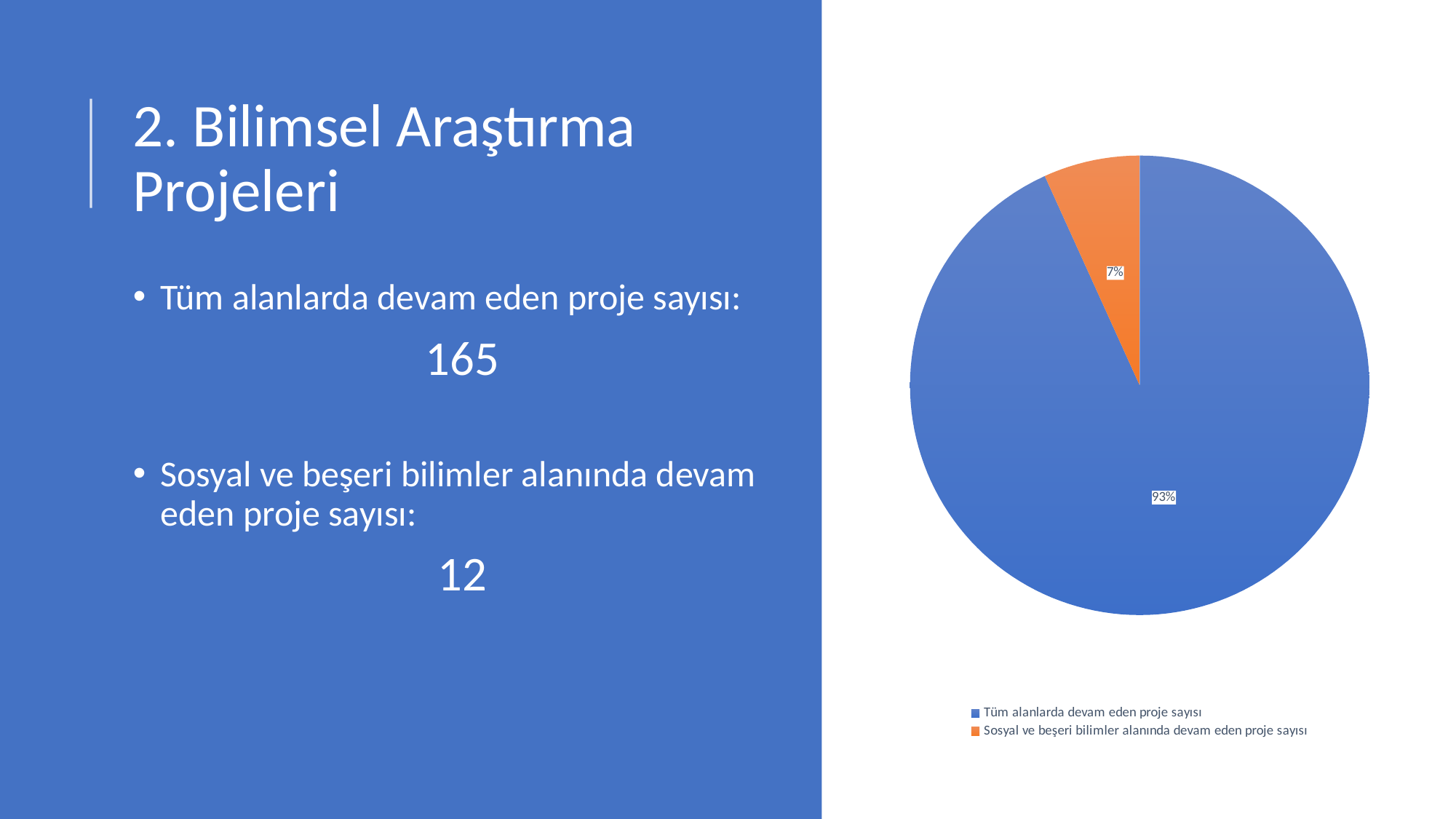
What kind of chart is shown on the slide? pie chart What share of the pie does "Sosyal ve beşeri bilimler alanında devam eden proje sayısı" take? 7% Which slice of the pie chart is the smallest? Sosyal ve beşeri bilimler alanında devam eden proje sayısı What colour is the slice for "Sosyal ve beşeri bilimler alanında devam eden proje sayısı" in the pie chart? orange What share of the pie does "Tüm alanlarda devam eden proje sayısı" take? 93% By how many percentage points does the 93% slice exceed the 7% slice? 86 Which is larger in the pie chart: the slice for "Tüm alanlarda devam eden proje sayısı" or the slice for "Sosyal ve beşeri bilimler alanında devam eden proje sayısı"? Tüm alanlarda devam eden proje sayısı What colour is the slice for "Tüm alanlarda devam eden proje sayısı" in the pie chart? blue How many slices does the pie chart have? 2 Which slice of the pie chart is the largest? Tüm alanlarda devam eden proje sayısı How many entries does the legend of the pie chart list? 2